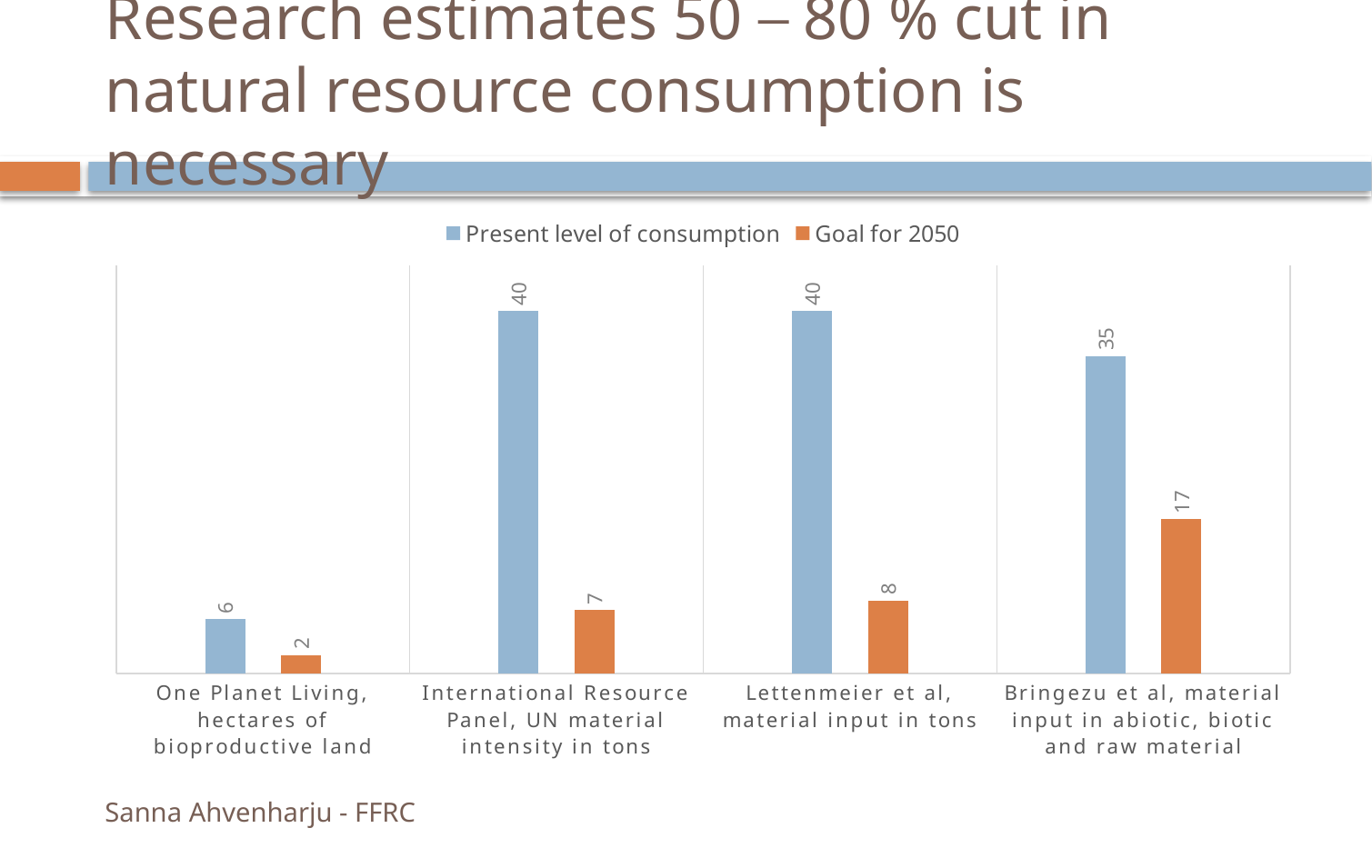
What is the Goal for 2050 value for Lettenmeier et al, material input in tons? 8 What is the Present level of consumption value for Bringezu et al, material input in abiotic, biotic and raw material? 35 Which category has the highest Goal for 2050 value? Bringezu et al, material input in abiotic, biotic and raw material Which category has the lowest Present level of consumption value? One Planet Living, hectares of bioproductive land What kind of chart is shown on the slide? Bar chart What is the difference between the Present level of consumption and the Goal for 2050 for Bringezu et al, material input in abiotic, biotic and raw material? 18 What is the Goal for 2050 value for One Planet Living, hectares of bioproductive land? 2 What is the Present level of consumption value for International Resource Panel, UN material intensity in tons? 40 What is the difference between the Present level of consumption and the Goal for 2050 for International Resource Panel, UN material intensity in tons? 33 How many categories are shown on the x axis of the chart? 4 Which is larger: the Goal for 2050 for Lettenmeier et al, material input in tons or the Goal for 2050 for International Resource Panel, UN material intensity in tons? Lettenmeier et al, material input in tons How many series does the chart legend list? 2